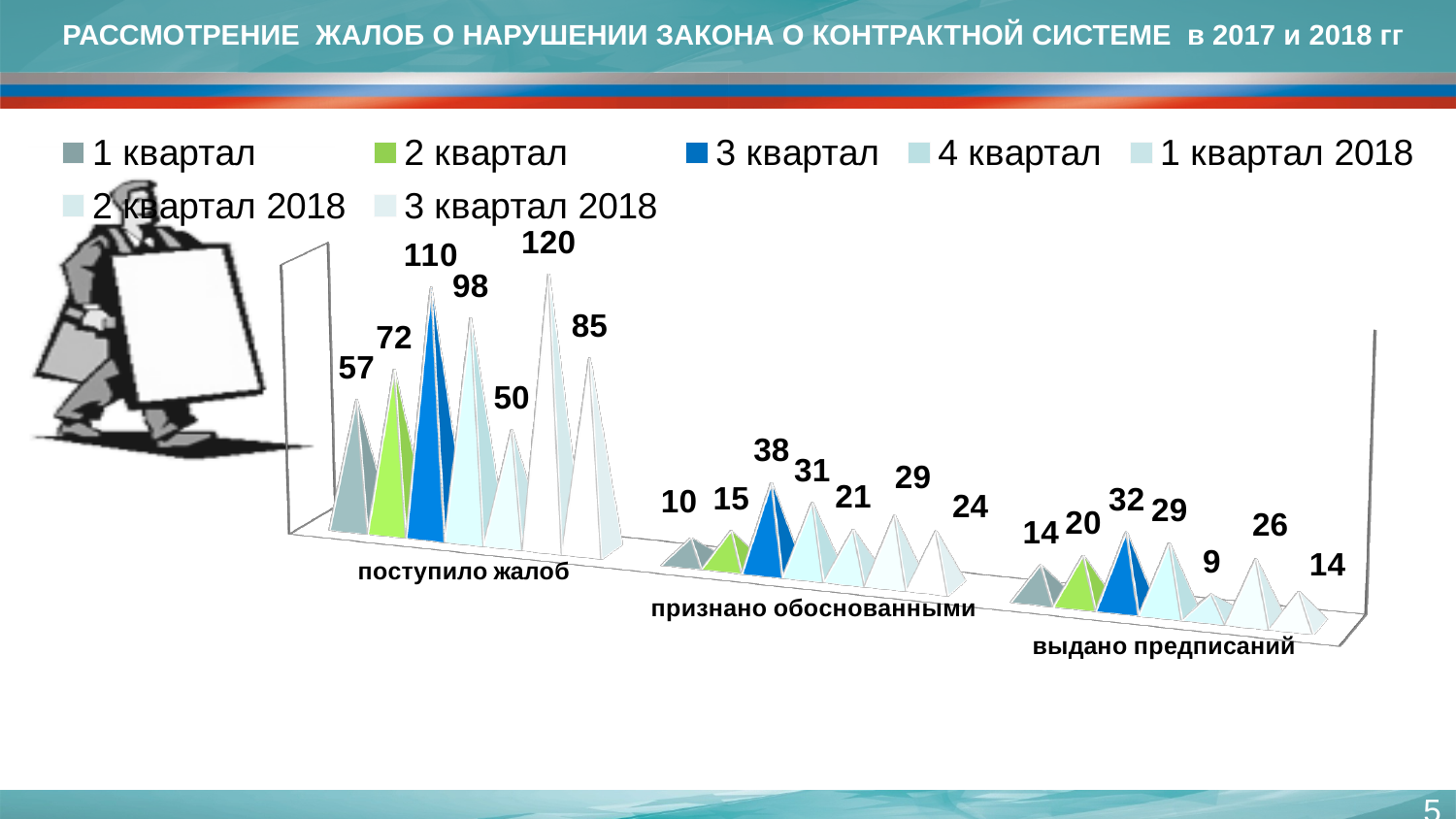
What is the value for 1 квартал in the category признано обоснованными? 10 What is the difference between the 3 квартал 2018 values for признано обоснованными and выдано предписаний? 10 Which series has the highest value in the category поступило жалоб? 2 квартал 2018 What is the value for 1 квартал 2018 in the category выдано предписаний? 9 How many categories are shown along the x axis? 3 What is the value for 3 квартал in the category поступило жалоб? 110 What is the title of the slide containing the chart? РАССМОТРЕНИЕ ЖАЛОБ О НАРУШЕНИИ ЗАКОНА О КОНТРАКТНОЙ СИСТЕМЕ в 2017 и 2018 гг Which series has the lowest value in the category признано обоснованными? 1 квартал How many series does the legend list? 7 What is the value for 2 квартал 2018 in the category поступило жалоб? 120 What is the difference between the 3 квартал and 4 квартал values in the category поступило жалоб? 12 Which is larger in the category выдано предписаний: the value for 3 квартал or the value for 2 квартал 2018? 3 квартал